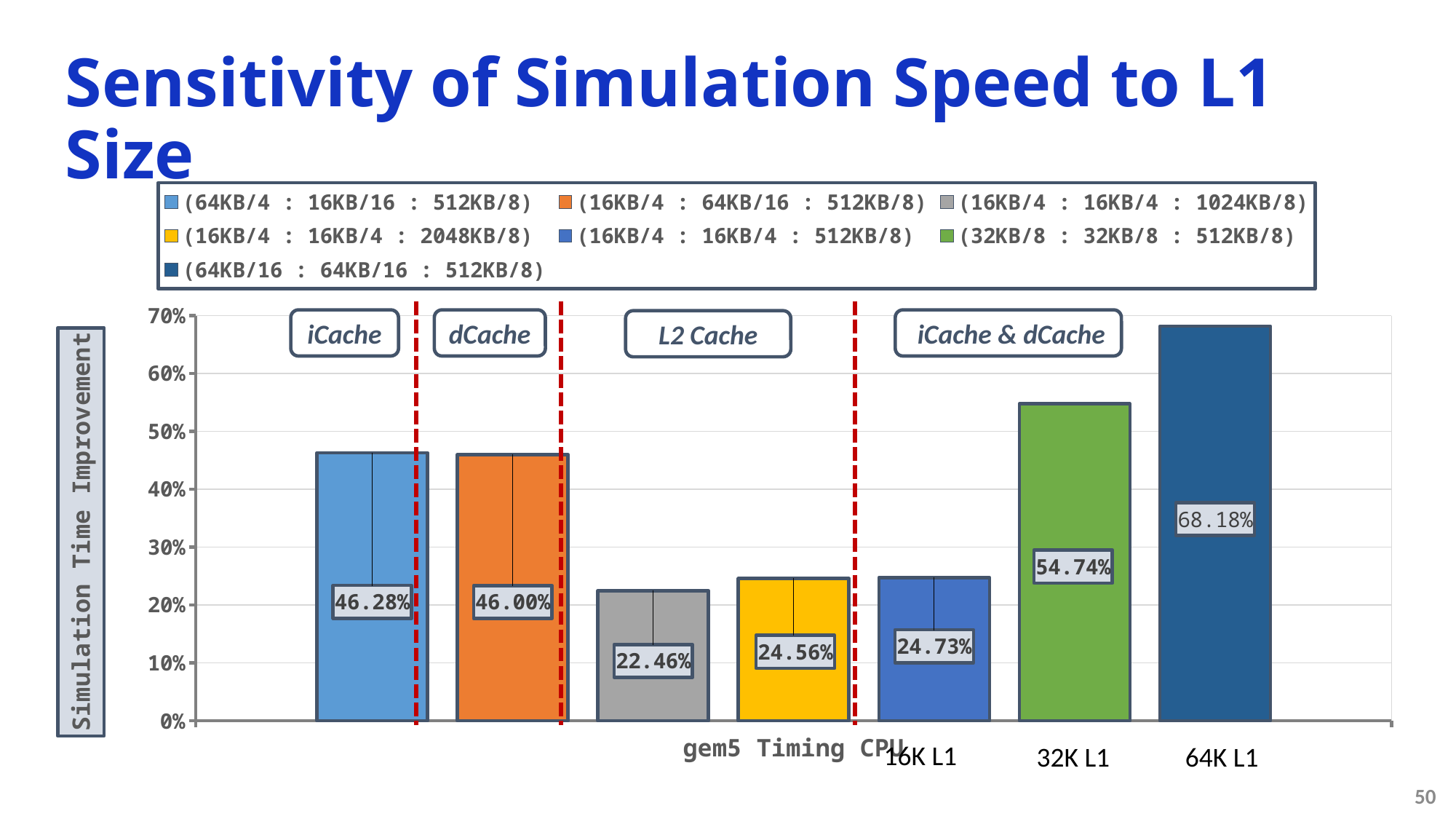
Which configuration has the lowest simulation time improvement? (16KB/4 : 16KB/4 : 1024KB/8) How many series does the legend list? 7 What is the simulation time improvement for the (16KB/4 : 64KB/16 : 512KB/8) configuration? 46.00% How many bars are plotted in the chart? 7 What is the simulation time improvement for the 64K L1 bar (64KB/16 : 64KB/16 : 512KB/8)? 68.18% What is the simulation time improvement for the (16KB/4 : 16KB/4 : 1024KB/8) configuration? 22.46% What is the simulation time improvement for the (64KB/4 : 16KB/16 : 512KB/8) configuration? 46.28% What type of chart is shown on the slide? bar chart Which has a larger simulation time improvement: the (16KB/4 : 16KB/4 : 2048KB/8) configuration or the (32KB/8 : 32KB/8 : 512KB/8) configuration? (32KB/8 : 32KB/8 : 512KB/8) What is the difference in simulation time improvement between the 64K L1 bar (68.18%) and the 32K L1 bar (54.74%)? 13.44% Which configuration has the highest simulation time improvement? (64KB/16 : 64KB/16 : 512KB/8) What is the label on the vertical axis of the chart? Simulation Time Improvement